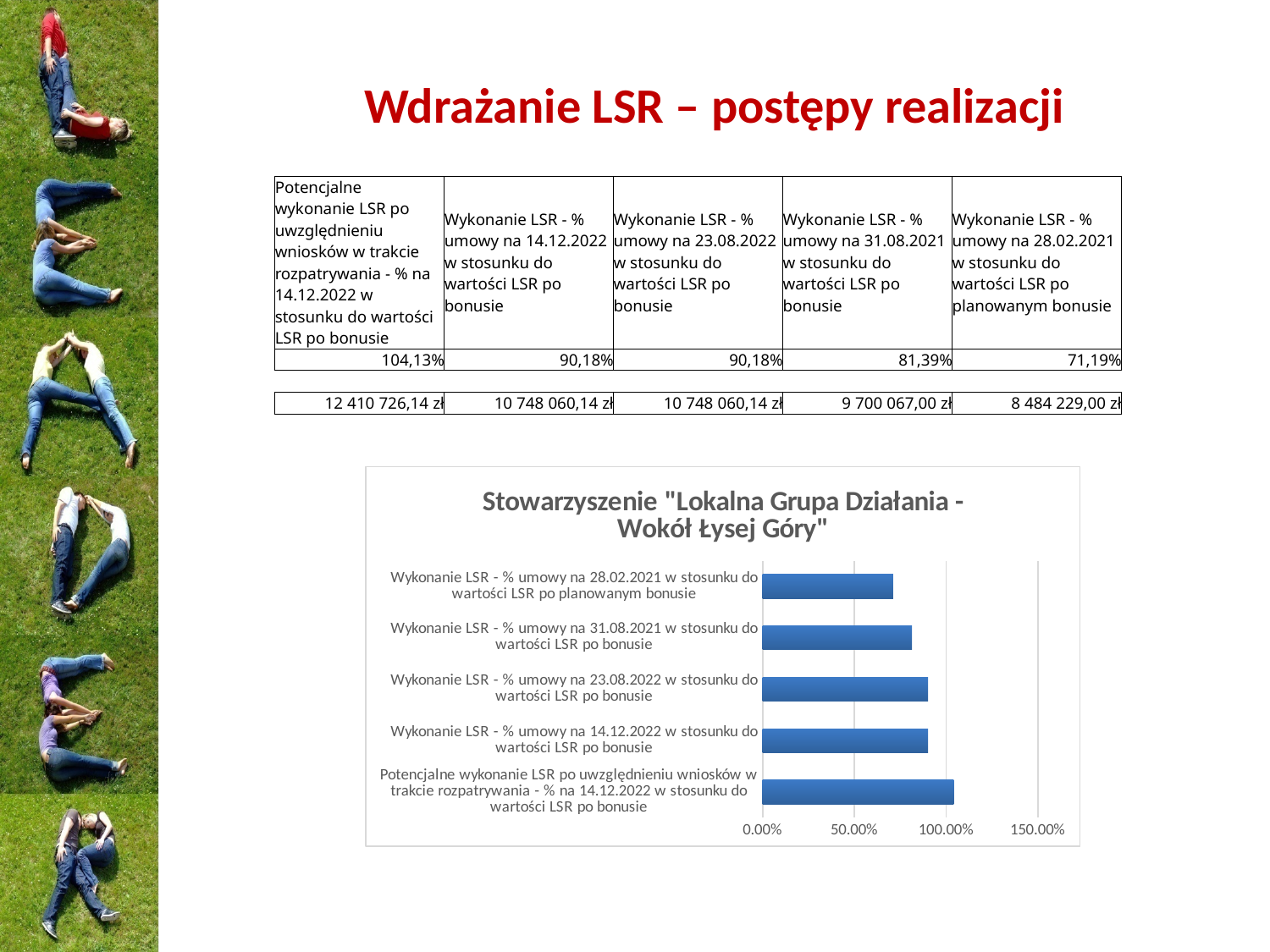
Is the value for "Potencjalne wykonanie LSR po uwzględnieniu wniosków w trakcie rozpatrywania - % na 14.12.2022 w stosunku do wartości LSR po bonusie" greater or less than 100.00%? greater Which category has the longest bar in the chart? Potencjalne wykonanie LSR po uwzględnieniu wniosków w trakcie rozpatrywania - % na 14.12.2022 w stosunku do wartości LSR po bonusie Which is larger: the value for "Wykonanie LSR - % umowy na 31.08.2021 w stosunku do wartości LSR po bonusie" or the value for "Wykonanie LSR - % umowy na 28.02.2021 w stosunku do wartości LSR po planowanym bonusie"? Wykonanie LSR - % umowy na 31.08.2021 w stosunku do wartości LSR po bonusie What kind of chart is shown on the slide? bar chart Is the value for "Wykonanie LSR - % umowy na 28.02.2021 w stosunku do wartości LSR po planowanym bonusie" greater or less than 100.00%? less Is the value for "Wykonanie LSR - % umowy na 31.08.2021 w stosunku do wartości LSR po bonusie" greater or less than 50.00%? greater What is the title of the chart? Stowarzyszenie "Lokalna Grupa Działania - Wokół Łysej Góry" How many categories (bars) does the chart show? 5 What colour are the bars in the chart? blue Going from the bottom bar to the top bar of the chart, do the values increase or decrease? decrease Which category has the shortest bar in the chart? Wykonanie LSR - % umowy na 28.02.2021 w stosunku do wartości LSR po planowanym bonusie Which is larger: the value for "Wykonanie LSR - % umowy na 23.08.2022 w stosunku do wartości LSR po bonusie" or the value for "Wykonanie LSR - % umowy na 28.02.2021 w stosunku do wartości LSR po planowanym bonusie"? Wykonanie LSR - % umowy na 23.08.2022 w stosunku do wartości LSR po bonusie